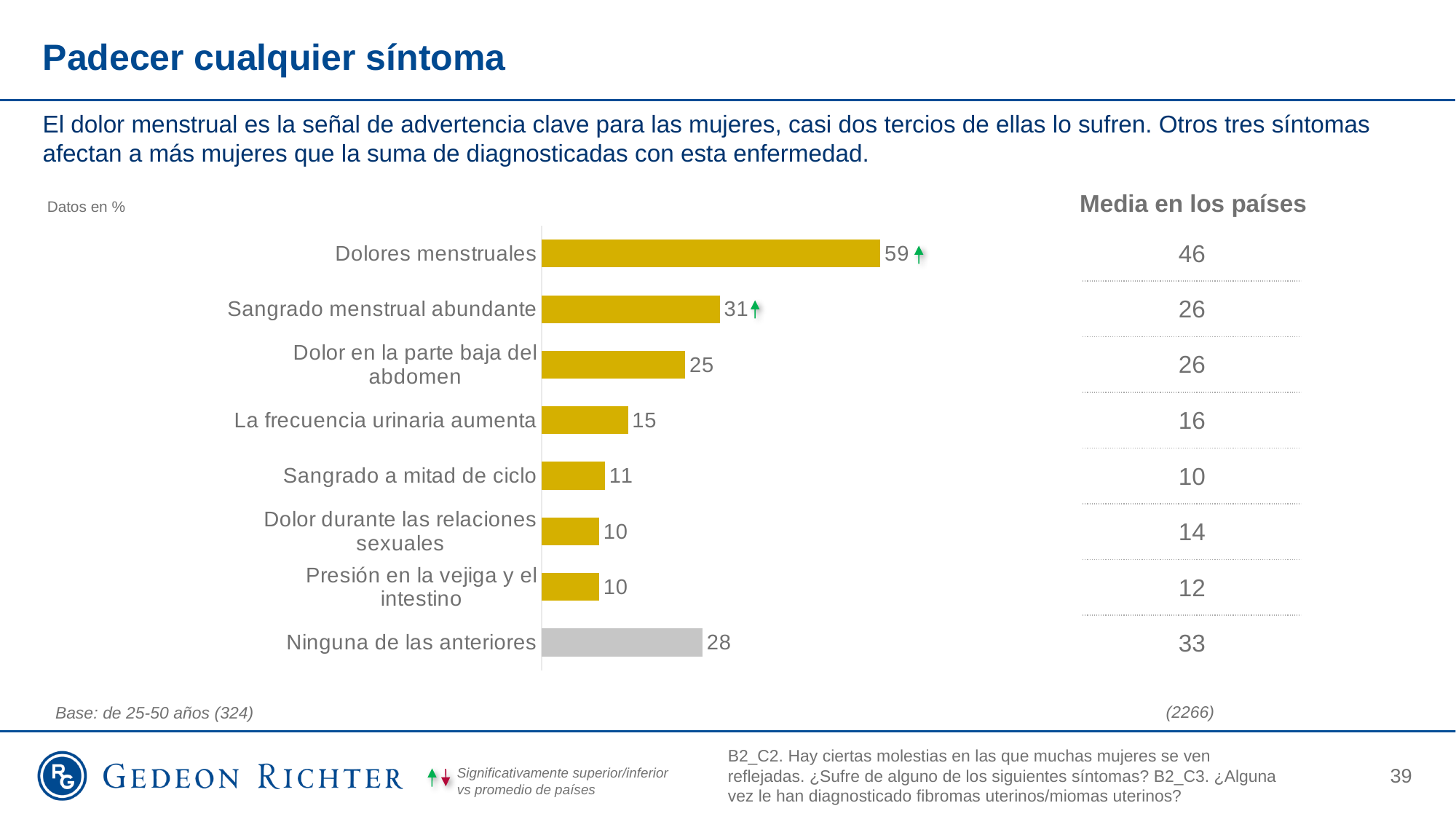
What kind of chart is shown on the slide? Bar chart What is the difference between the value for "Sangrado a mitad de ciclo" and the value for "Dolor durante las relaciones sexuales"? 1 What is the difference between the values for "Dolores menstruales" and "Sangrado menstrual abundante"? 28 What is the value for "Dolores menstruales"? 59 Which bar is shown in grey rather than yellow? Ninguna de las anteriores What is the value for "Sangrado menstrual abundante"? 31 What is the "Media en los países" value for "Dolores menstruales"? 46 What is the value for "La frecuencia urinaria aumenta"? 15 What is the value for "Ninguna de las anteriores"? 28 Which is larger, the value for "Dolor en la parte baja del abdomen" or the value for "Ninguna de las anteriores"? Ninguna de las anteriores How many categories are shown in the chart? 8 Which category has the highest value? Dolores menstruales